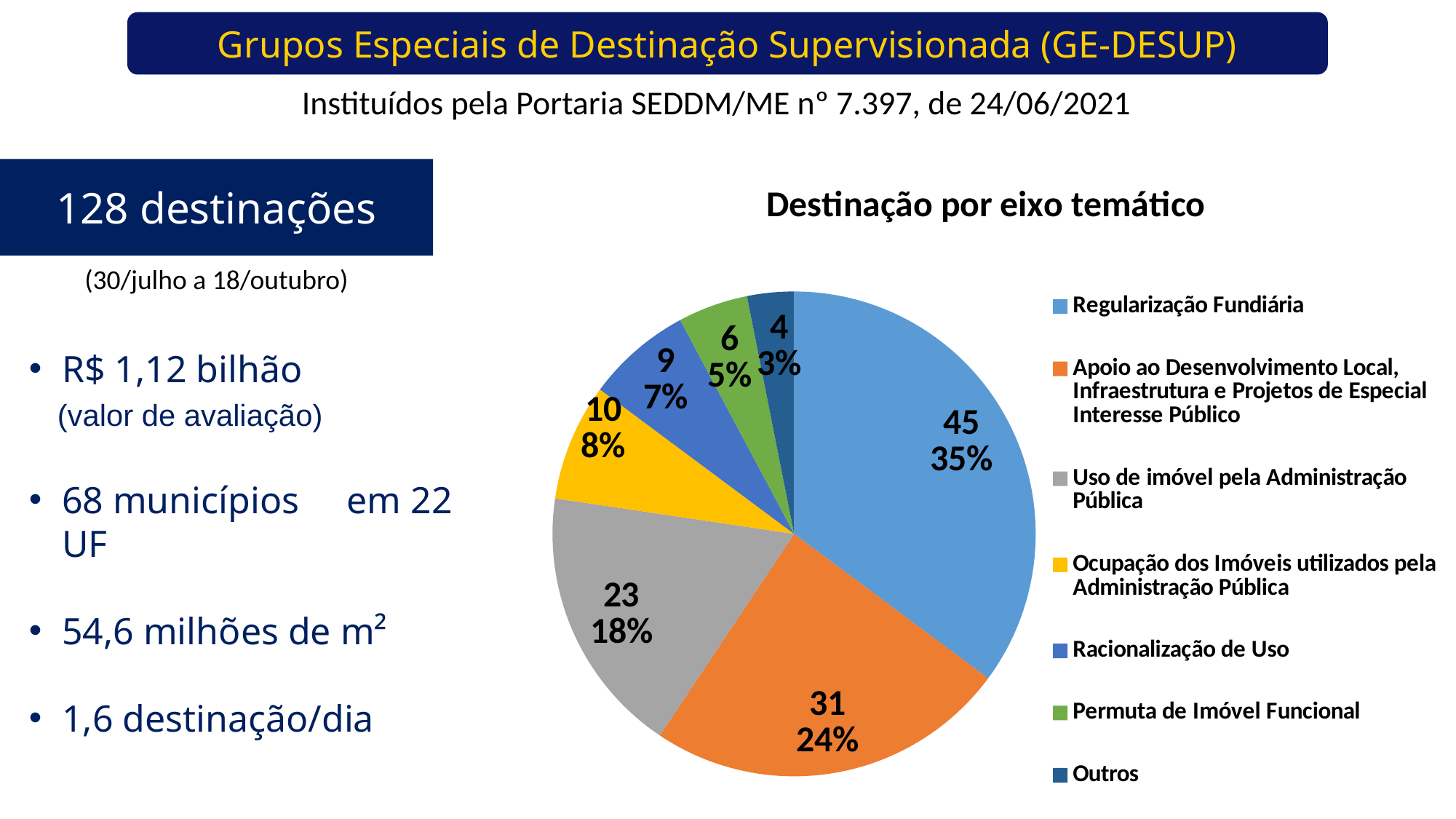
What kind of chart is shown under the title "Destinação por eixo temático"? Pie chart Which category has the smallest slice in the pie chart? Outros What percentage share does Regularização Fundiária have in the pie chart? 35% What is the title of the chart on the slide? Destinação por eixo temático What is the count shown for Regularização Fundiária in the pie chart? 45 What colour is the slice for Outros in the pie chart? Dark blue What is the difference between the counts for Regularização Fundiária and Apoio ao Desenvolvimento Local, Infraestrutura e Projetos de Especial Interesse Público? 14 How many slices does the pie chart have? 7 What is the count shown for Uso de imóvel pela Administração Pública? 23 Which is larger in the pie chart: Ocupação dos Imóveis utilizados pela Administração Pública or Permuta de Imóvel Funcional? Ocupação dos Imóveis utilizados pela Administração Pública Which category has the largest slice in the pie chart? Regularização Fundiária What percentage share does Racionalização de Uso have in the pie chart? 7%